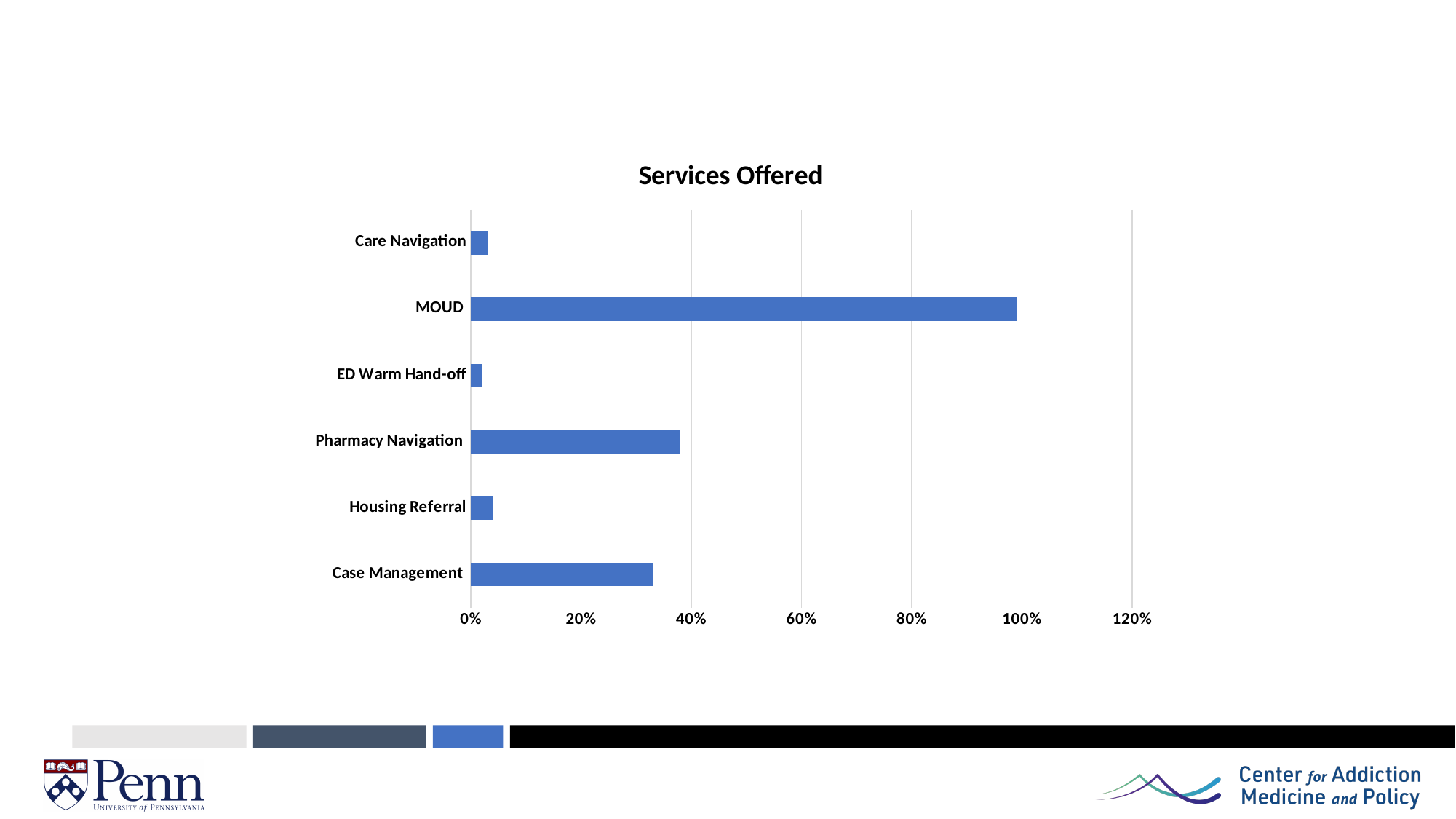
Is the value for Case Management greater or less than 20%? greater What is the title of the chart? Services Offered Is the value for Housing Referral greater or less than 20%? less Which service has the highest value in the chart? MOUD What is the highest tick label shown on the horizontal axis? 120% Is the value for Pharmacy Navigation greater or less than 40%? less Which is larger, the value for MOUD or the value for Pharmacy Navigation? MOUD What kind of chart is shown on the slide? bar chart Which is larger, the value for Case Management or the value for Housing Referral? Case Management How many service categories are plotted in the chart? 6 Which is larger, the value for Pharmacy Navigation or the value for Case Management? Pharmacy Navigation